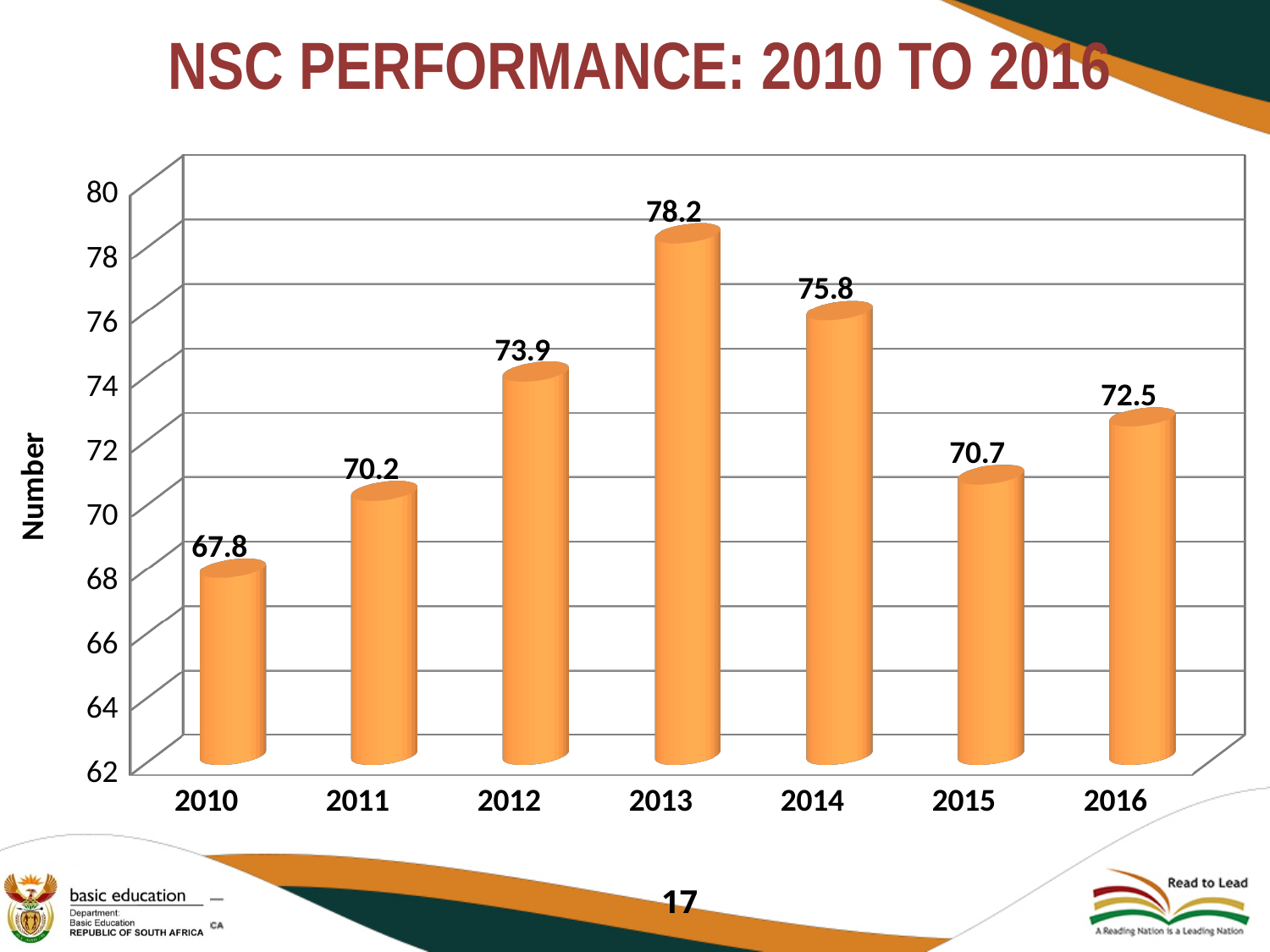
Which year has the lowest value? 2010 What is the value for 2010? 67.8 How many years are shown on the x axis? 7 What kind of chart is shown on the slide? bar chart What is the difference between the values for 2013 and 2010? 10.4 Is the value for 2015 greater or less than 72? less Which year has the highest value? 2013 What is the value for 2013? 78.2 Which is larger, the value for 2012 or the value for 2016? 2012 What is the difference between the values for 2014 and 2015? 5.1 What is the value for 2016? 72.5 What is the title of the chart? NSC PERFORMANCE: 2010 TO 2016